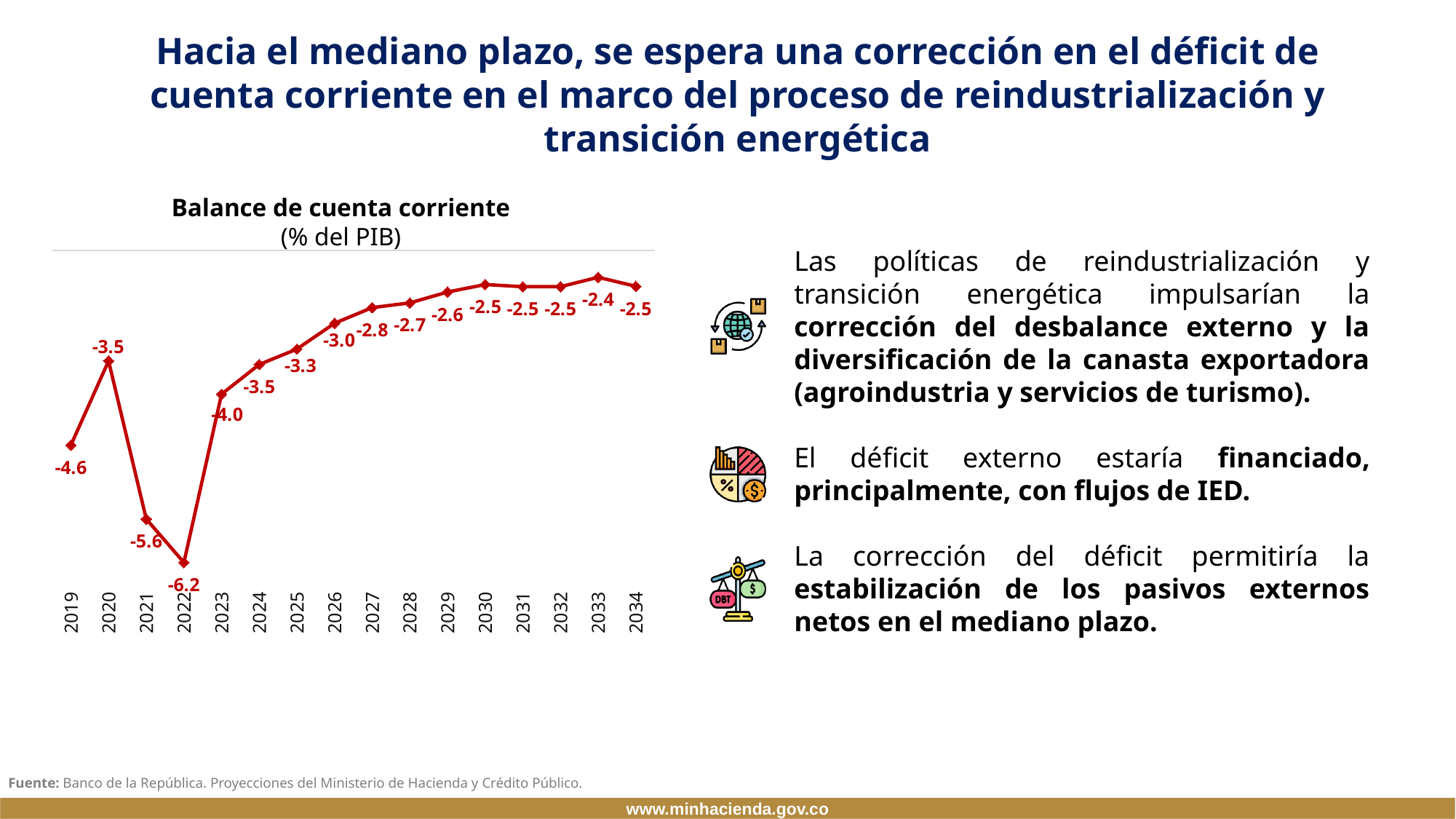
Which year has the lowest value in the 'Balance de cuenta corriente' chart? 2022 What kind of chart is the 'Balance de cuenta corriente' chart? Line chart What is the difference between the values for 2034 and 2022 in the 'Balance de cuenta corriente' chart? 3.7 In what unit are the values of the 'Balance de cuenta corriente' chart expressed? % del PIB Which year has the larger value in the 'Balance de cuenta corriente' chart, 2021 or 2023? 2023 What is the value for 2025 in the 'Balance de cuenta corriente' chart? -3.3 What is the value for 2022 in the 'Balance de cuenta corriente' chart? -6.2 What is the value for 2019 in the 'Balance de cuenta corriente' chart? -4.6 How many years are plotted in the 'Balance de cuenta corriente' chart? 16 Do the values in the 'Balance de cuenta corriente' chart rise or fall from 2022 to 2033? Rise What is the value for 2034 in the 'Balance de cuenta corriente' chart? -2.5 Which year has the highest value in the 'Balance de cuenta corriente' chart? 2033